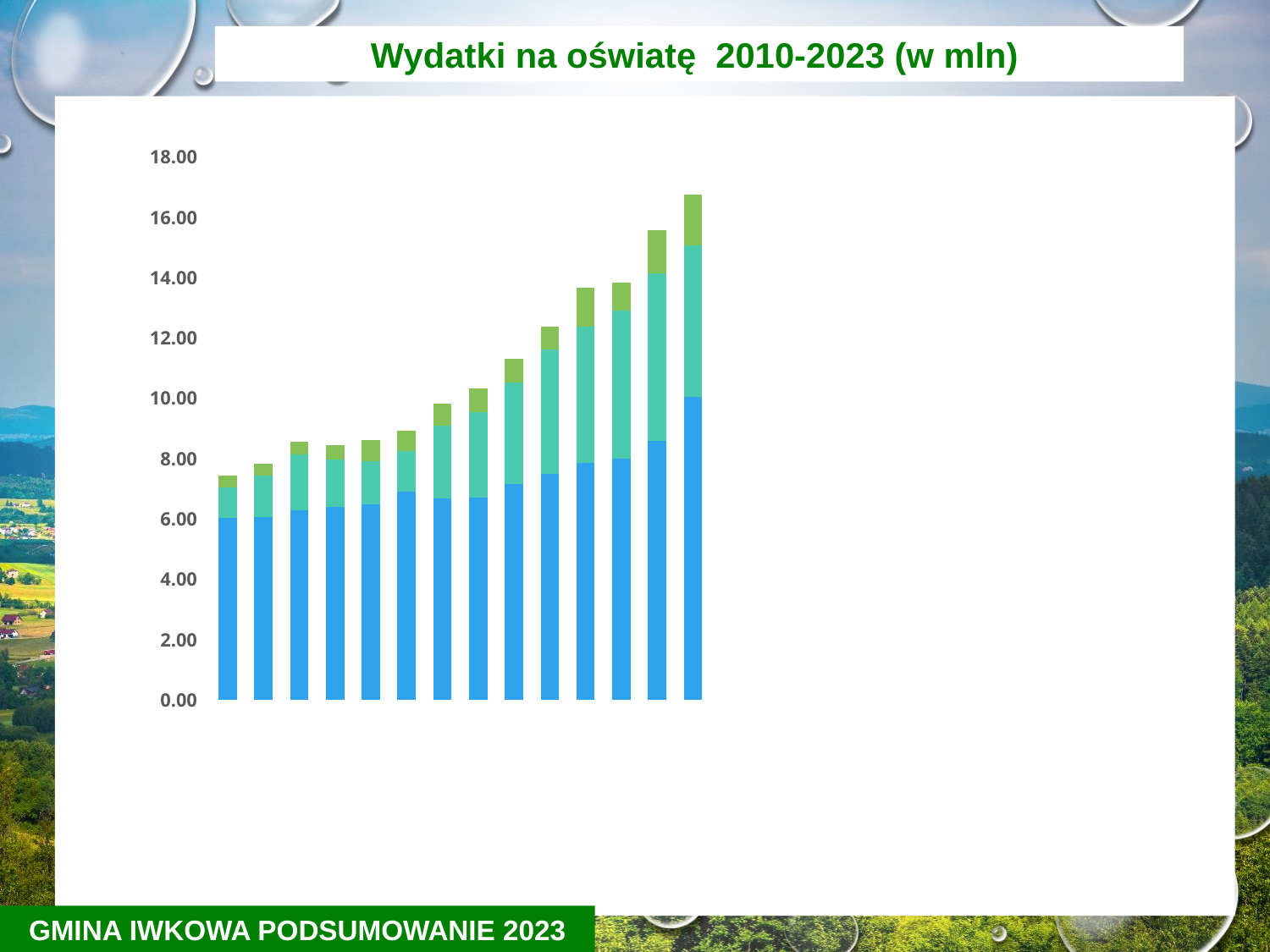
Is the blue segment of the rightmost bar greater or less than 8.00? greater What is the title of the chart? Wydatki na oświatę 2010-2023 (w mln) Do the total bar heights generally rise or fall from left to right? rise How many bars are plotted in the chart? 14 Is the total value of the rightmost bar greater or less than 16.00? greater What type of chart is shown on the slide? bar chart Which bar has the greatest total height? the rightmost (last) bar How many coloured segments is each bar stacked from? 3 Is the total value of the second bar from the right greater or less than 16.00? less Which is larger, the total of the rightmost bar or the total of the leftmost bar? the rightmost bar Which bar has the smallest total height? the leftmost (first) bar